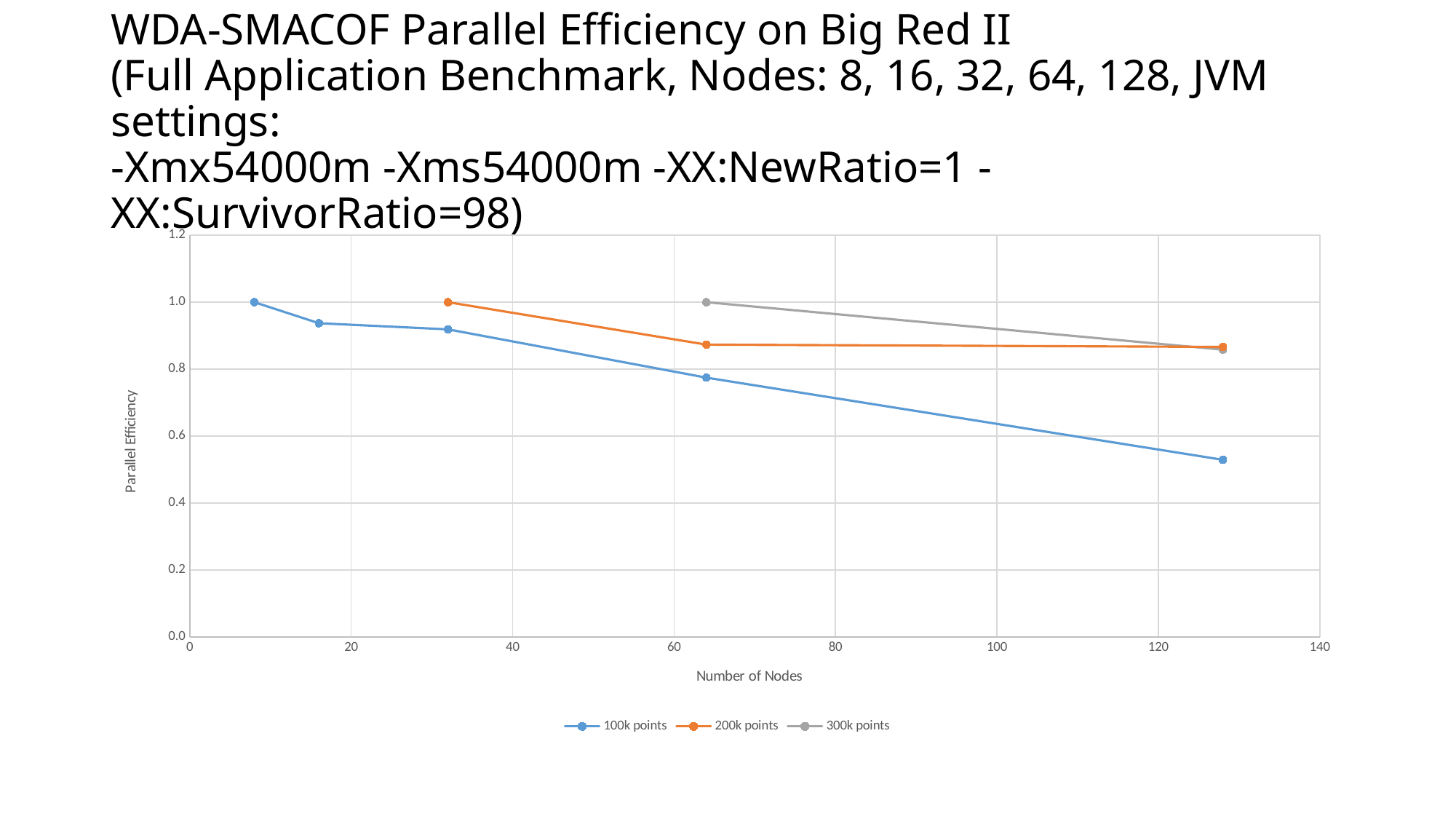
Which series has the lowest parallel efficiency at 128 nodes? 100k points Does the parallel efficiency of the 100k points series rise or fall as the number of nodes increases? fall What kind of chart is shown on the slide? line chart What is the parallel efficiency of the 100k points series at 8 nodes? 1.0 At 128 nodes, which series has the higher parallel efficiency, 100k points or 200k points? 200k points Is the parallel efficiency of the 100k points series at 128 nodes greater or less than 0.6? less Is the parallel efficiency of the 200k points series at 64 nodes greater or less than 0.8? greater What is the title of the y axis? Parallel Efficiency How many data points are plotted for the 300k points series? 2 What is the title of the x axis? Number of Nodes How many data points are plotted for the 100k points series? 5 How many series does the legend list? 3